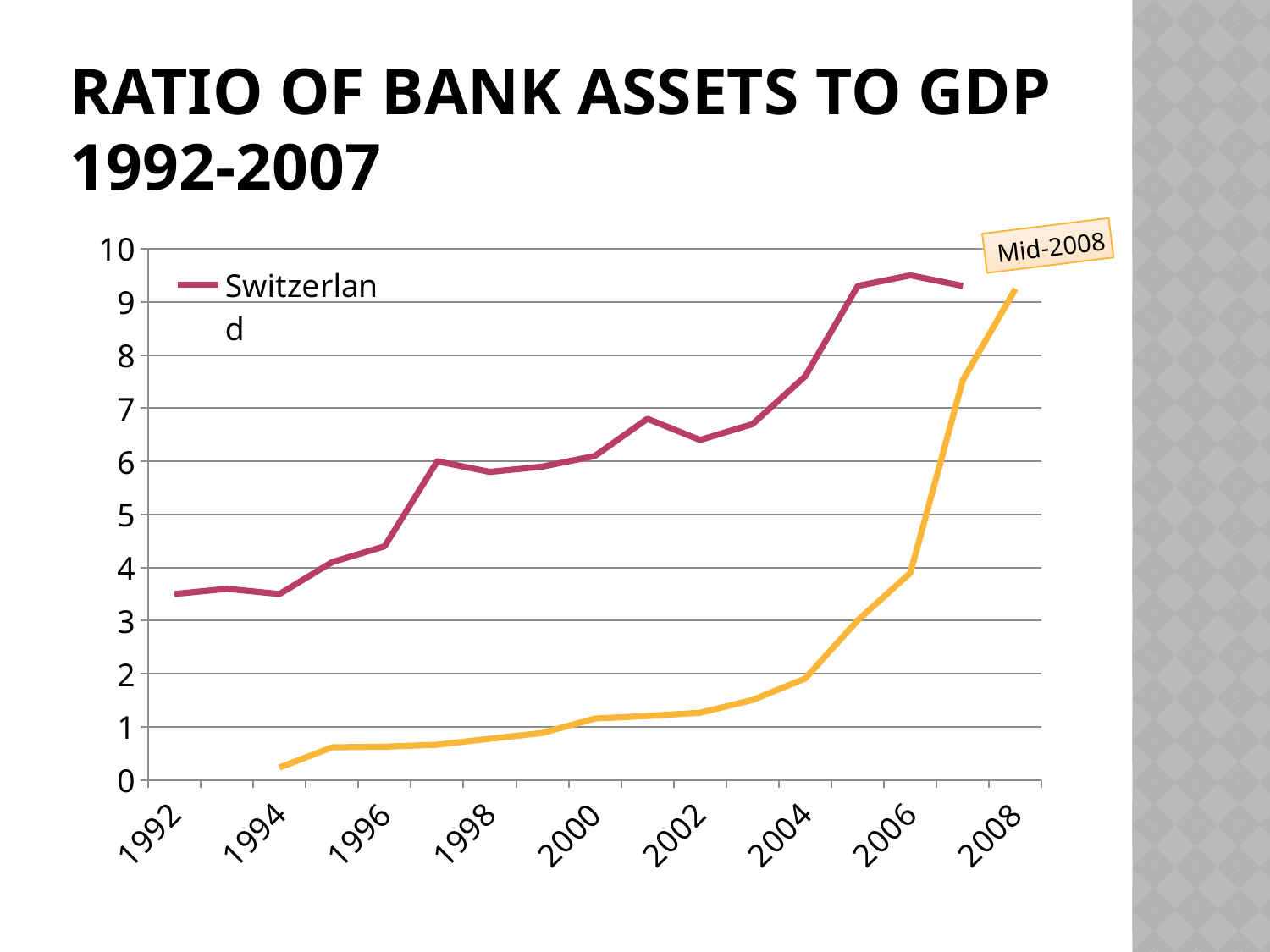
What kind of chart is shown on the slide? line chart Is the value for Switzerland in 2002 greater or less than 6? greater Is the value for Switzerland in 2006 greater or less than 9? greater How many series does the legend list? 1 Does the Switzerland line generally rise or fall from 1992 to 2007? rise Which is larger for Switzerland, the value in 1992 or the value in 2006? 2006 Is the value for Switzerland in 2004 greater or less than 7? greater In 2004, which line is higher, the Switzerland line or the orange line? Switzerland What is the title of the chart on the slide? RATIO OF BANK ASSETS TO GDP 1992-2007 Which series is named in the legend? Switzerland